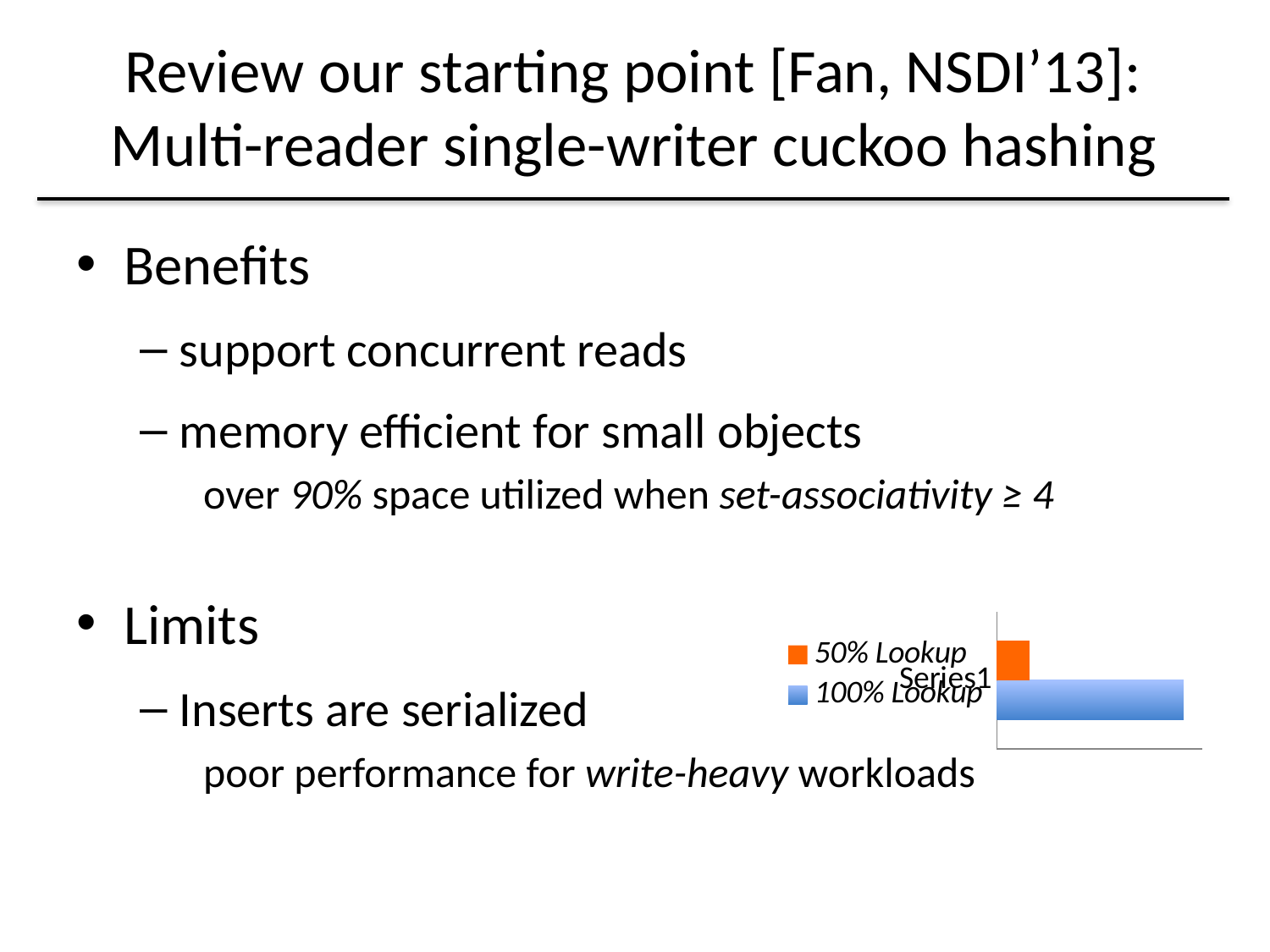
Which series has the lowest value in the chart? 50% Lookup How many categories are plotted on the chart's category axis? 1 Which series has the highest value in the chart? 100% Lookup Which series has the longer bar, 50% Lookup or 100% Lookup? 100% Lookup How many series does the chart's legend list? 2 Which colour represents the 50% Lookup series in the chart? orange Are the bars in the chart drawn horizontally or vertically? horizontally What kind of chart is shown on the slide? bar chart What is the label of the category shown on the chart's axis? Series1